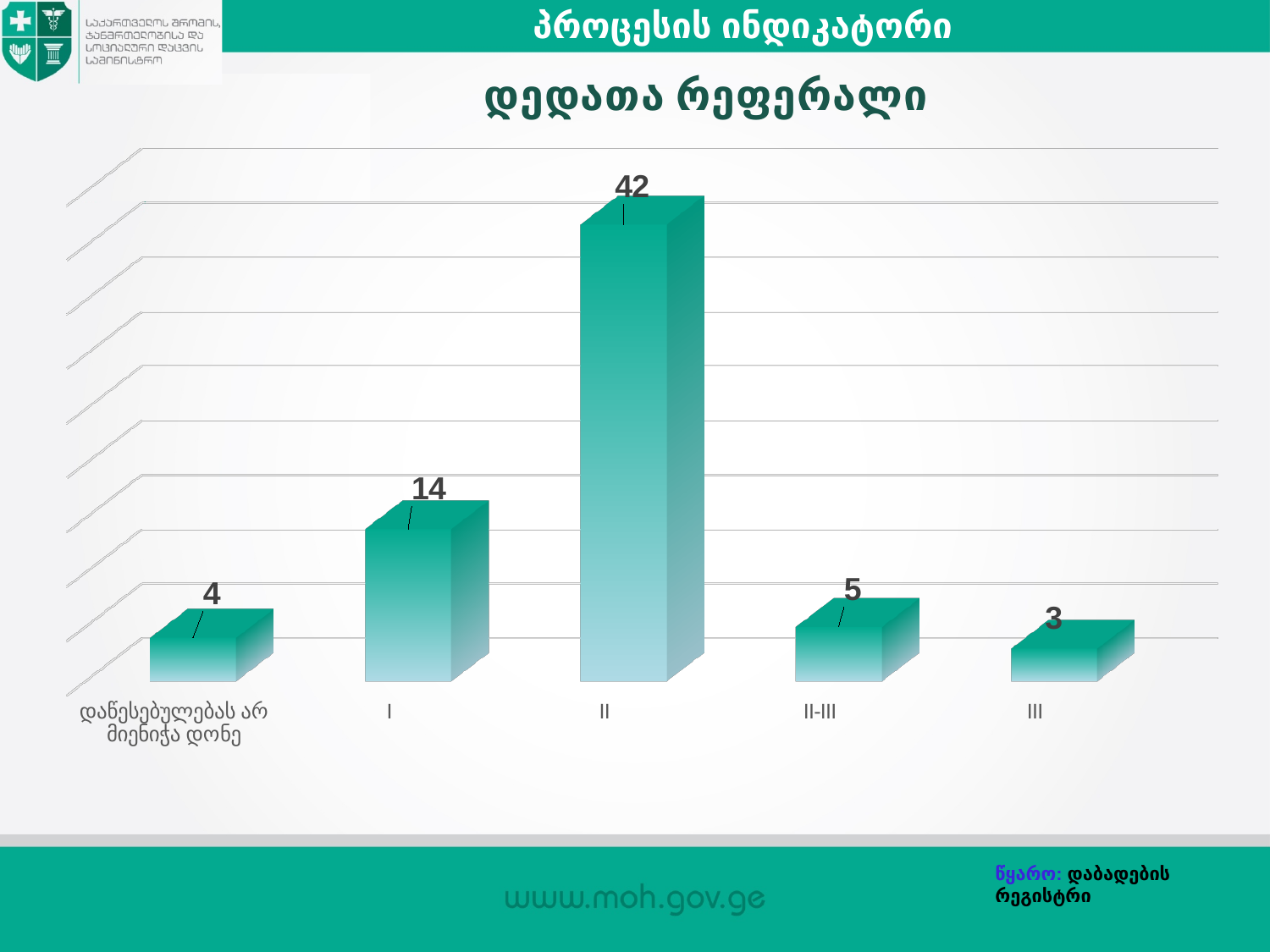
Which category has the highest value? II What is the value for category I? 14 What type of chart is shown on the slide? Bar chart What is the value for category II-III? 5 What is the value for category II? 42 How many categories are shown on the chart? 5 Which category has the lowest value? III What is the difference between the values for category II and category I? 28 What is the difference between the values for category II-III and category III? 2 Which is larger, the value for category I or the value for category II-III? I What is the value for category III? 3 What is the value for the category "დაწესებულებას არ მიენიჭა დონე"? 4